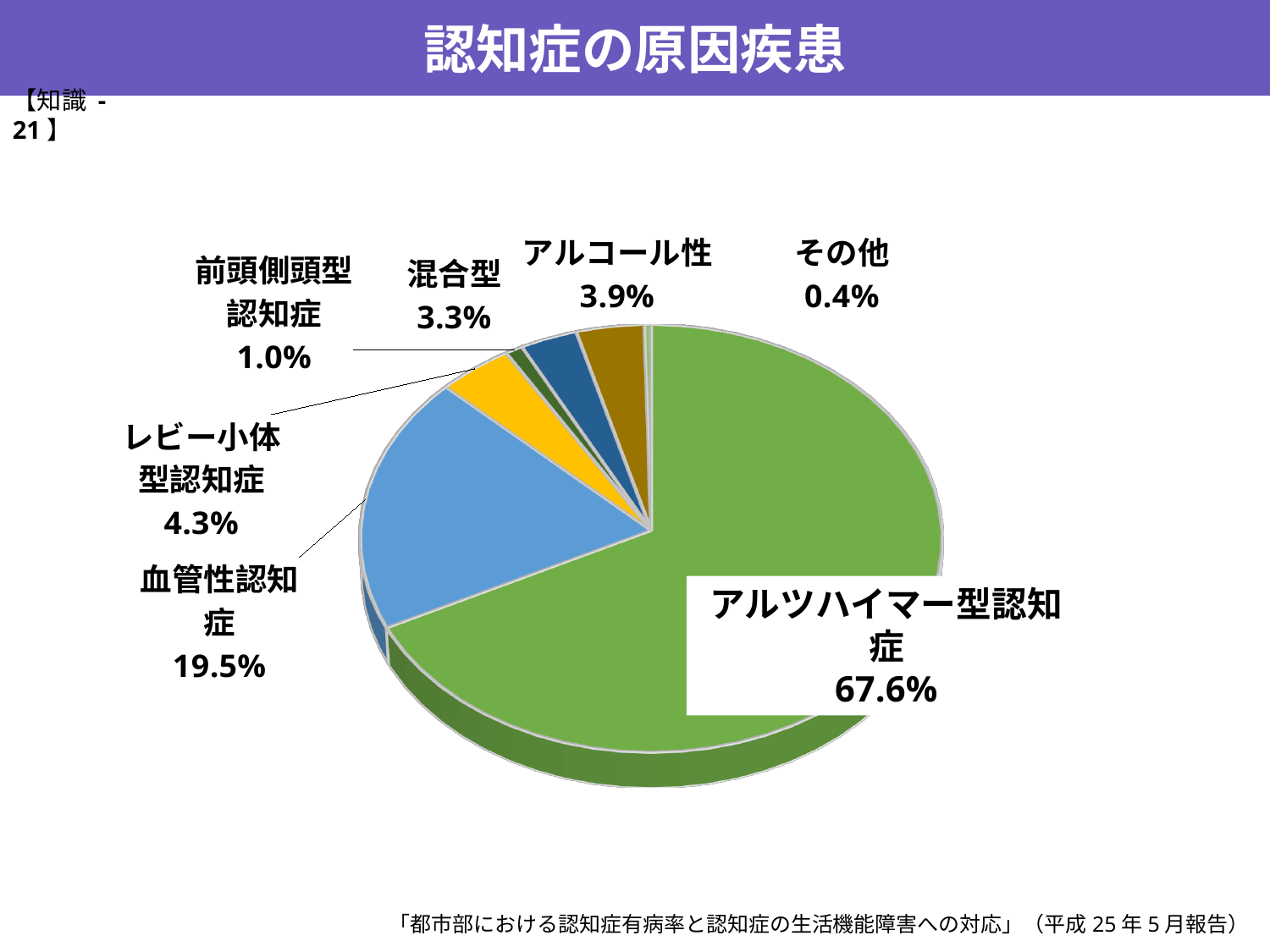
What percentage does the chart show for 血管性認知症? 19.5% What kind of chart is shown on the slide? Pie chart What percentage does the chart show for 前頭側頭型認知症? 1.0% Which is larger, 混合型 or アルコール性? アルコール性 Which category has the largest slice of the pie? アルツハイマー型認知症 Which category has the smallest slice of the pie? その他 How many categories are shown in the pie chart? 7 What percentage does the chart show for レビー小体型認知症? 4.3% What percentage does the chart show for アルコール性? 3.9% What is the title of the slide containing the chart? 認知症の原因疾患 What is the difference in percentage points between アルツハイマー型認知症 and 血管性認知症? 48.1% What percentage does the chart show for アルツハイマー型認知症? 67.6%